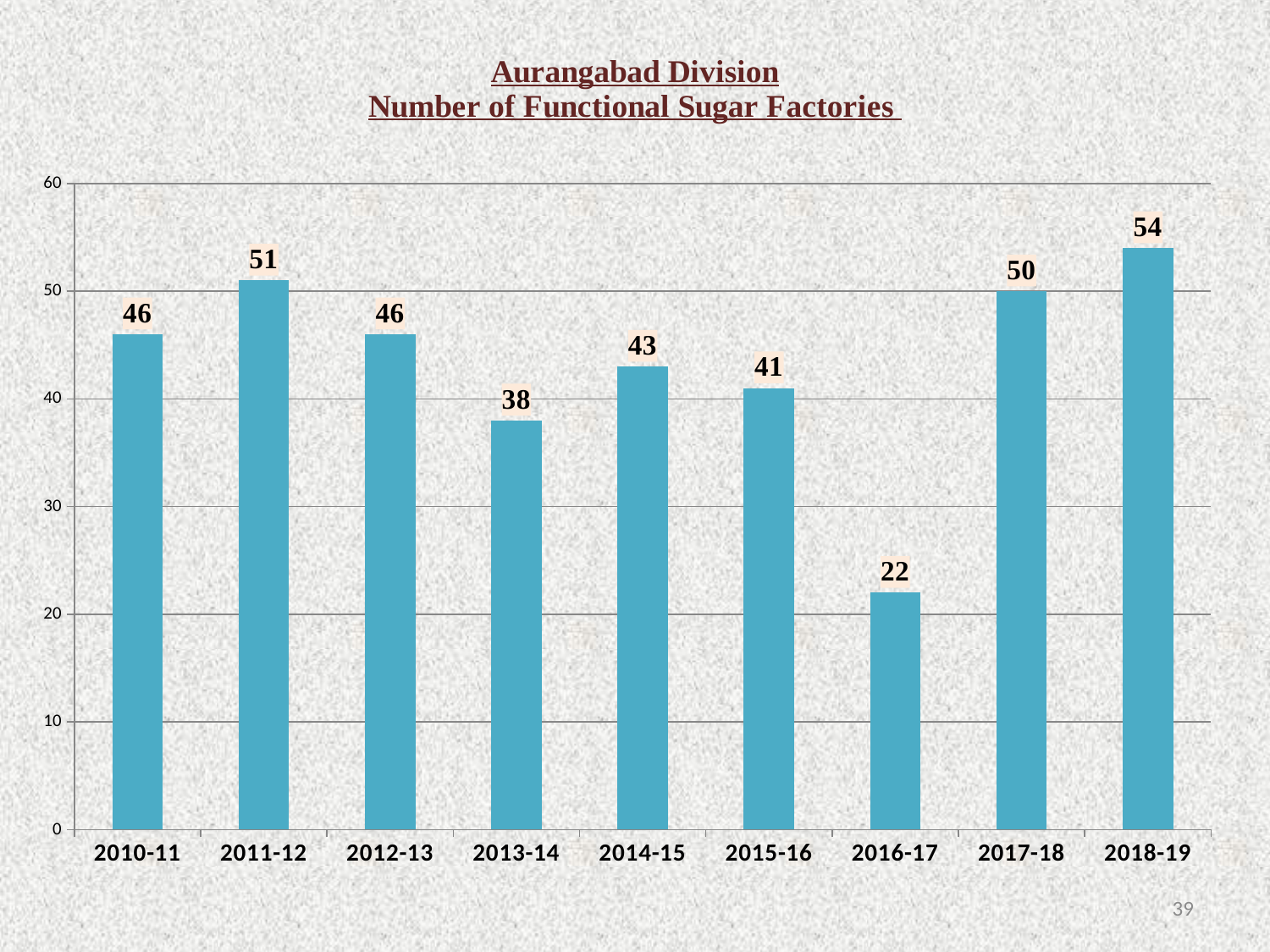
What is the number of functional sugar factories in 2016-17? 22 What is the difference between the number of functional sugar factories in 2018-19 and 2016-17? 32 Does the number of functional sugar factories rise or fall from 2016-17 to 2018-19? rise What kind of chart is shown on the slide? bar chart Which year has the highest number of functional sugar factories? 2018-19 What is the title of the chart? Aurangabad Division Number of Functional Sugar Factories How many years are shown on the x axis of the chart? 9 What is the number of functional sugar factories in 2013-14? 38 Which year has more functional sugar factories, 2014-15 or 2015-16? 2014-15 Which year has the lowest number of functional sugar factories? 2016-17 What is the difference between the values for 2011-12 and 2010-11? 5 Is the value for 2017-18 greater or less than 40? greater